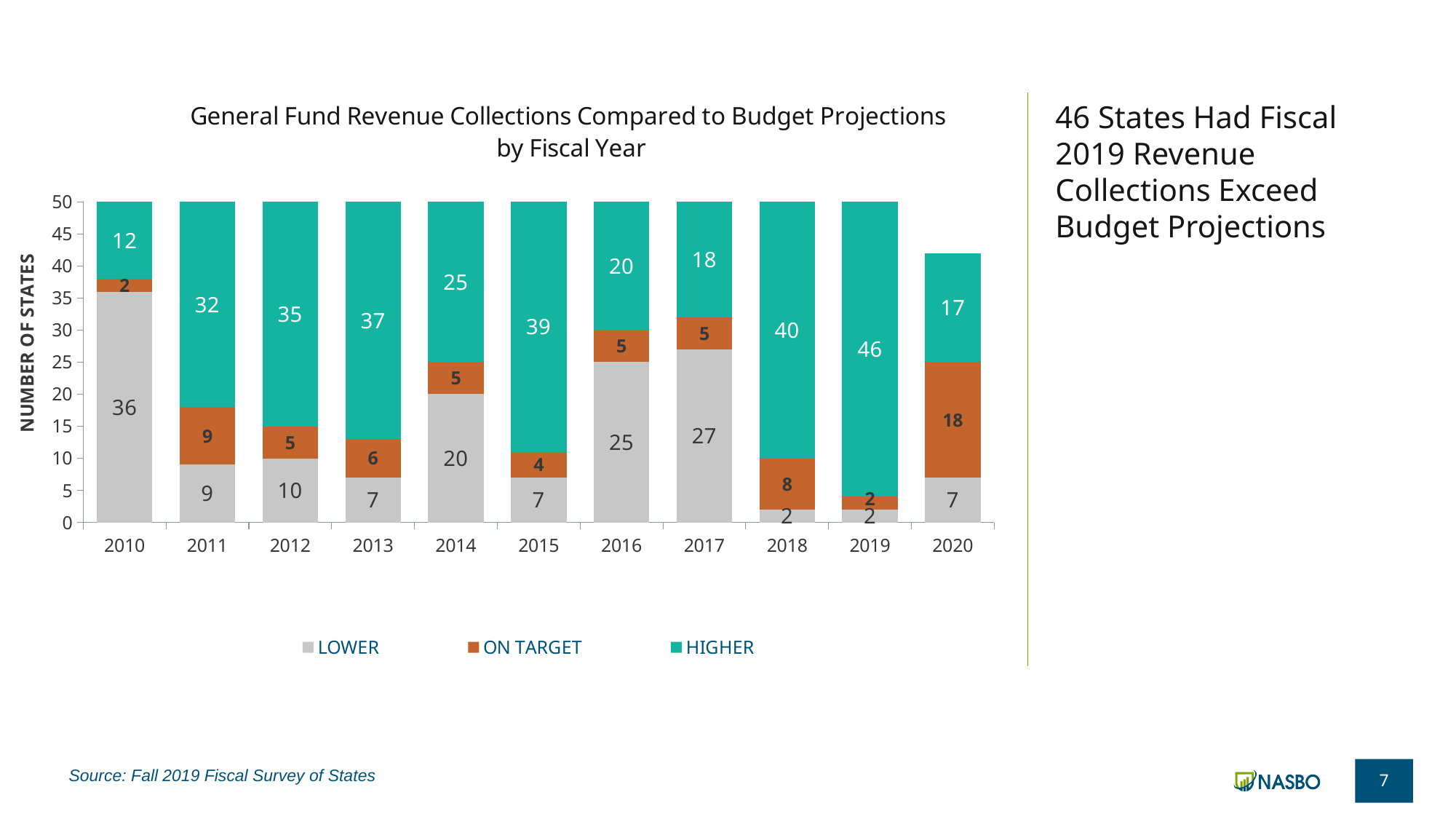
What is the ON TARGET value for fiscal 2020? 18 How many states had revenue collections HIGHER than budget projections in fiscal 2019? 46 How many series does the legend list? 3 In which fiscal year is the HIGHER series at its minimum? 2010 What is the LOWER value for fiscal 2010? 36 What is the difference between the HIGHER values for 2019 and 2018? 6 Which is larger, the LOWER value for 2016 or the LOWER value for 2017? 2017 What is the total of the stacked bar for fiscal 2020? 42 In which fiscal year is the HIGHER series at its maximum? 2019 What kind of chart is shown on the slide? Stacked bar chart What is the title of the chart? General Fund Revenue Collections Compared to Budget Projections by Fiscal Year How many fiscal years are shown on the x axis? 11